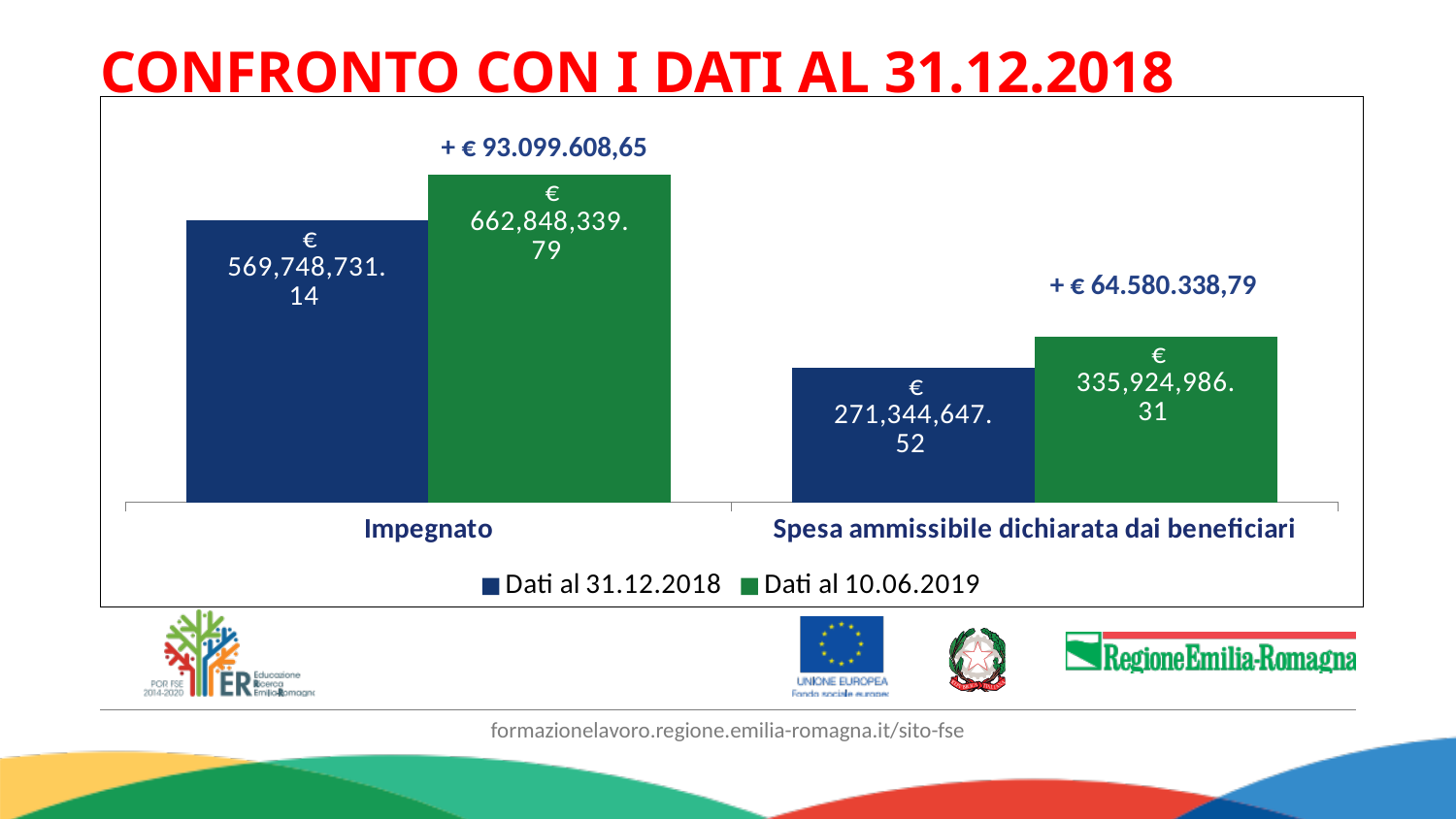
For Impegnato, which series has the larger value: Dati al 31.12.2018 or Dati al 10.06.2019? Dati al 10.06.2019 How many categories are shown on the x axis? 2 What is the increase shown for Impegnato between Dati al 31.12.2018 and Dati al 10.06.2019? + € 93.099.608,65 What is the value for Impegnato in the Dati al 10.06.2019 series? € 662,848,339.79 What is the value for Spesa ammissibile dichiarata dai beneficiari in the Dati al 31.12.2018 series? € 271,344,647.52 What is the increase shown for Spesa ammissibile dichiarata dai beneficiari between Dati al 31.12.2018 and Dati al 10.06.2019? + € 64.580.338,79 Which bar has the lowest value in the chart? Spesa ammissibile dichiarata dai beneficiari, Dati al 31.12.2018 What is the value for Spesa ammissibile dichiarata dai beneficiari in the Dati al 10.06.2019 series? € 335,924,986.31 What kind of chart is shown on the slide? bar chart How many series does the legend list? 2 Which bar has the highest value in the chart? Impegnato, Dati al 10.06.2019 What is the value for Impegnato in the Dati al 31.12.2018 series? € 569,748,731.14